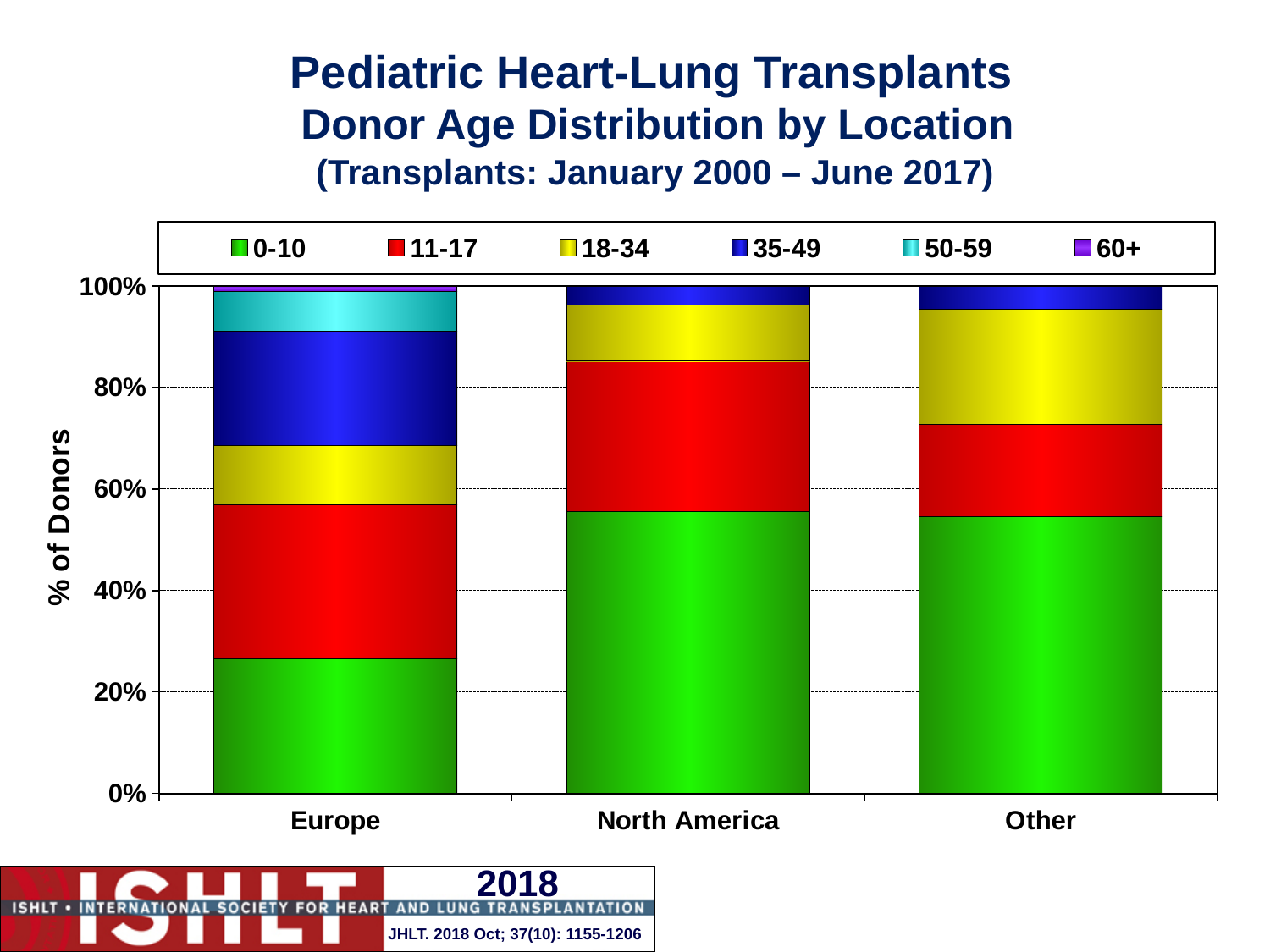
What transplant date range is given in the chart title? January 2000 – June 2017 Which location has a larger share of donors aged 35-49, Europe or North America? Europe How many locations are shown on the x axis? 3 What is the label on the y axis? % of Donors Is the share of donors aged 0-10 in Europe greater or less than 20%? greater What kind of chart is shown on the slide? Stacked bar chart Is the share of donors aged 0-10 in Europe greater or less than 40%? less How many donor age groups does the legend list? 6 Which location has the largest share of donors aged 18-34? Other Which location has the smallest share of donors aged 0-10? Europe Which location has a larger share of donors aged 0-10, Europe or North America? North America Is the share of donors aged 0-10 in North America greater or less than 40%? greater